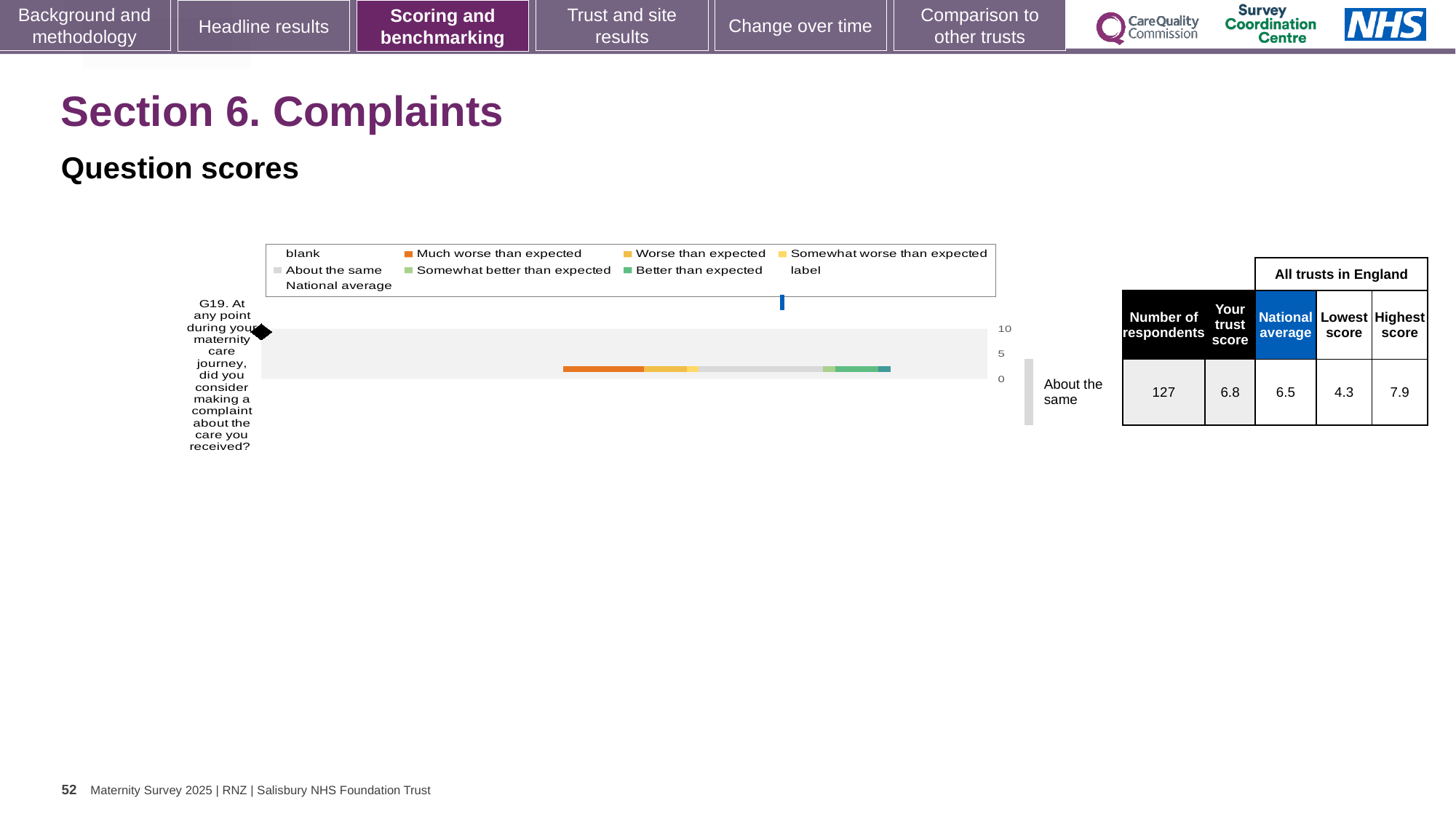
What is the lowest score among all trusts in England for question G19? 4.3 What is the trust score for question G19? 6.8 What kind of chart is shown on the slide? bar chart How many survey questions are plotted in the chart? 1 What is the highest score among all trusts in England for question G19? 7.9 How many respondents answered question G19? 127 What is the national average score for question G19? 6.5 Which benchmark category is shown next to the bar for question G19? About the same Is the trust score for question G19 greater or less than 5? greater What colour in the legend represents 'Much worse than expected'? orange Which is larger for question G19: the trust score or the national average? the trust score What is the difference between the highest and lowest scores for question G19? 3.6